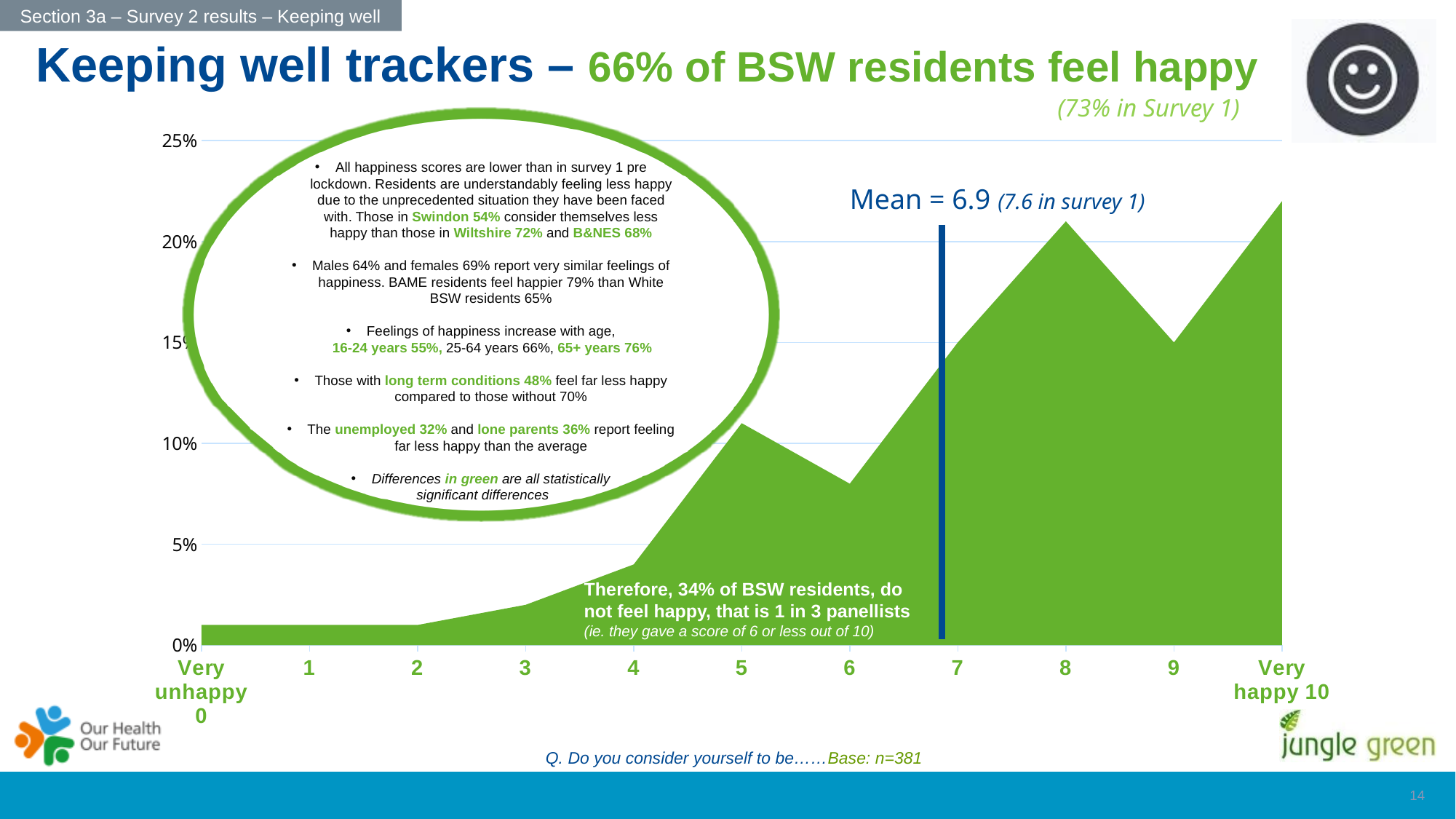
Which has the larger value, score 8 or score 6? 8 Is the value for score 8 greater or less than 15%? greater Which has the larger value, score 9 or score 3? 9 What kind of chart is shown on the slide? Area chart Is the value for score 4 greater or less than 5%? less Is the value for score 6 greater or less than 10%? less What mean happiness score is shown on the chart? 6.9 How many score points are plotted along the x axis of the chart? 11 Which has the larger value, score 5 or score 6? 5 Overall, do the values rise or fall as the happiness score moves from 0 to 10? rise